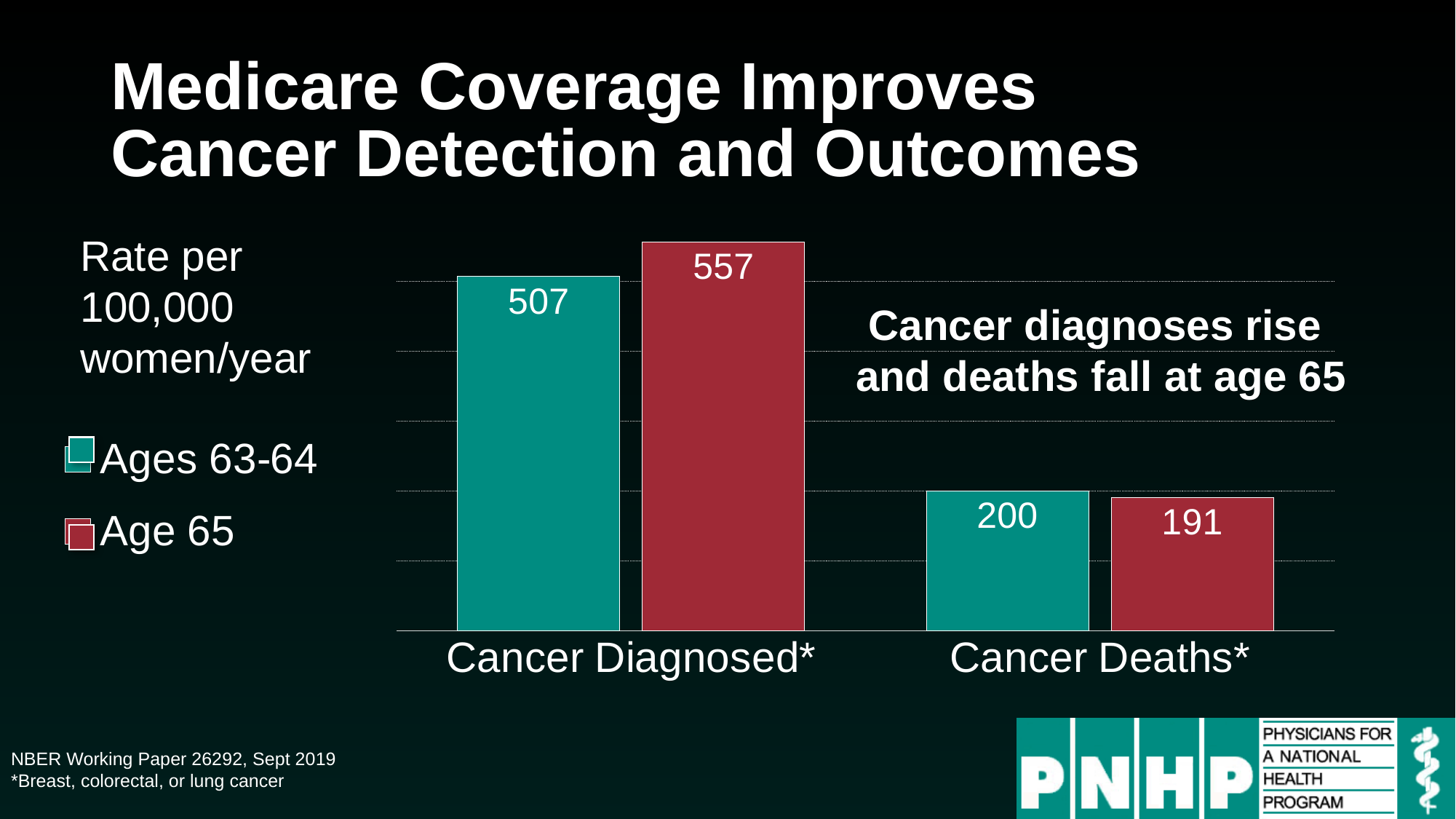
What kind of chart is shown on the slide? Bar chart What is the difference between the Age 65 and Ages 63-64 Cancer Diagnosed rates? 50 What is the Cancer Diagnosed rate for Ages 63-64? 507 Which series has the higher Cancer Diagnosed rate, Ages 63-64 or Age 65? Age 65 How many categories are shown on the x axis? 2 What is the Cancer Diagnosed rate for Age 65? 557 How many series does the legend list? 2 What is the Cancer Deaths rate for Ages 63-64? 200 What is the difference between the Ages 63-64 and Age 65 Cancer Deaths rates? 9 What is the Cancer Deaths rate for Age 65? 191 Which bar has the highest value on the chart? Age 65, Cancer Diagnosed (557) Which series has the lower Cancer Deaths rate, Ages 63-64 or Age 65? Age 65